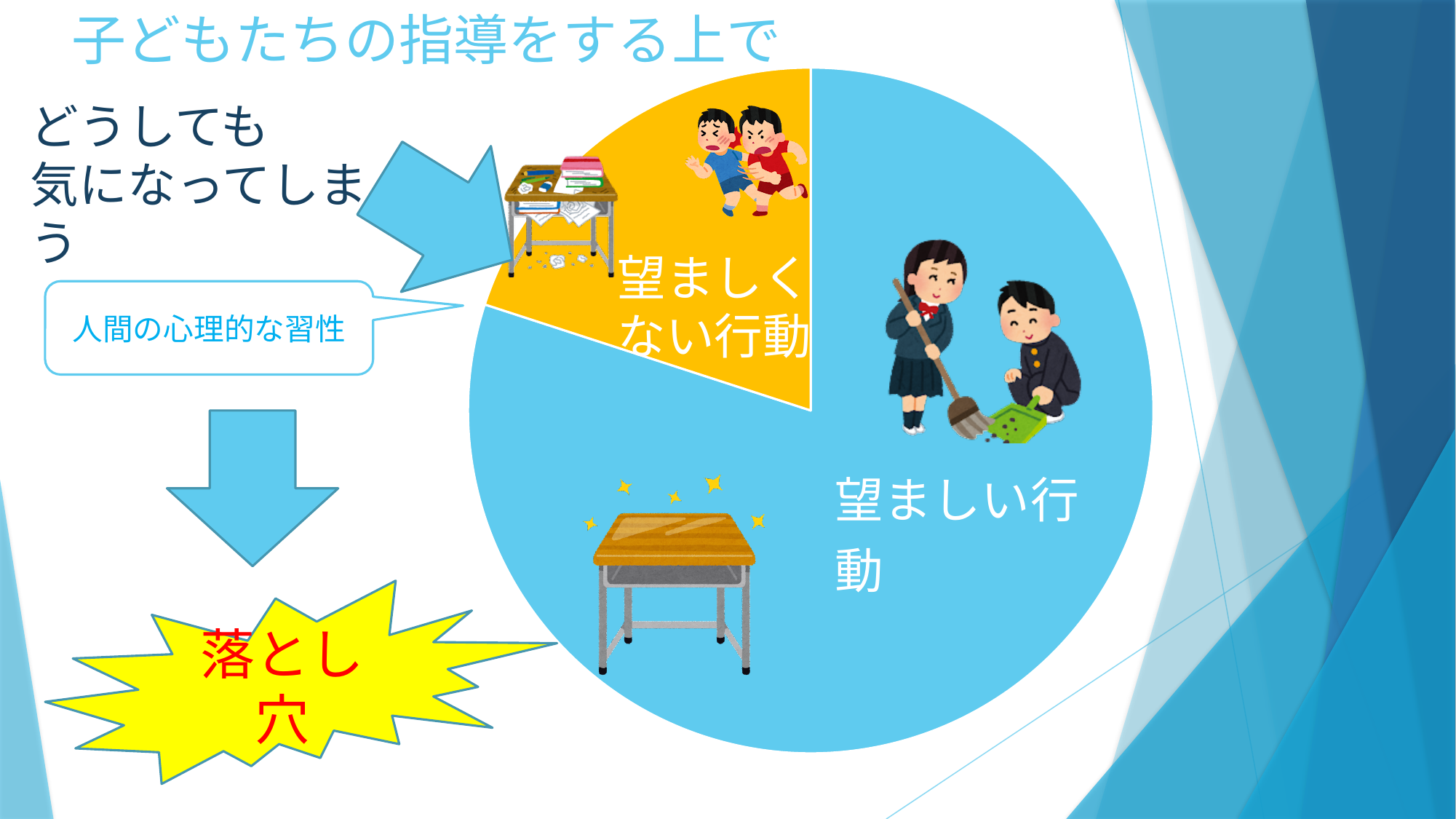
How many slices does the pie chart have? 2 What kind of chart is shown on the slide? pie chart What colour is the 望ましくない行動 slice of the pie chart? orange Which slice of the pie chart is the largest? 望ましい行動 What colour is the 望ましい行動 slice of the pie chart? blue Which slice is larger, 望ましい行動 or 望ましくない行動? 望ましい行動 Which slice of the pie chart is the smallest? 望ましくない行動